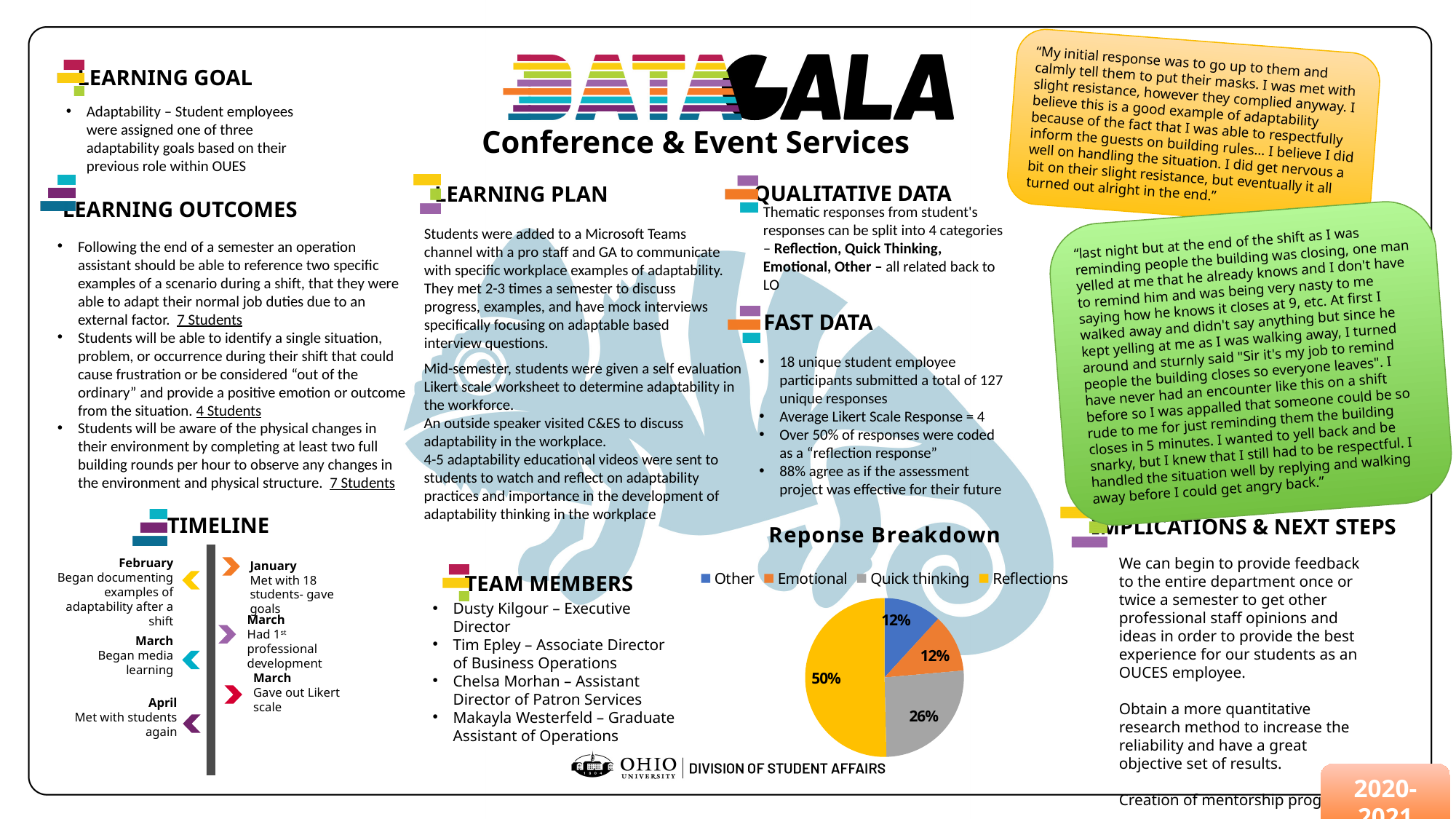
In the "Reponse Breakdown" pie chart, what share do Reflections have? 50% In the "Reponse Breakdown" pie chart, what share does Quick thinking have? 26% In the "Reponse Breakdown" pie chart, what is the difference between the Reflections share and the Quick thinking share? 24% Which category has the largest slice in the "Reponse Breakdown" pie chart? Reflections In the "Reponse Breakdown" pie chart, what is the combined share of Other and Emotional? 24% In the "Reponse Breakdown" pie chart, what share does Other have? 12% In the "Reponse Breakdown" pie chart, which is larger, Quick thinking or Emotional? Quick thinking In the "Reponse Breakdown" pie chart, what share does Emotional have? 12% What is the title of the pie chart on the slide? Reponse Breakdown How many categories does the legend of the "Reponse Breakdown" pie chart list? 4 What colour is the Reflections slice in the "Reponse Breakdown" pie chart? yellow What kind of chart is shown under the title "Reponse Breakdown"? pie chart